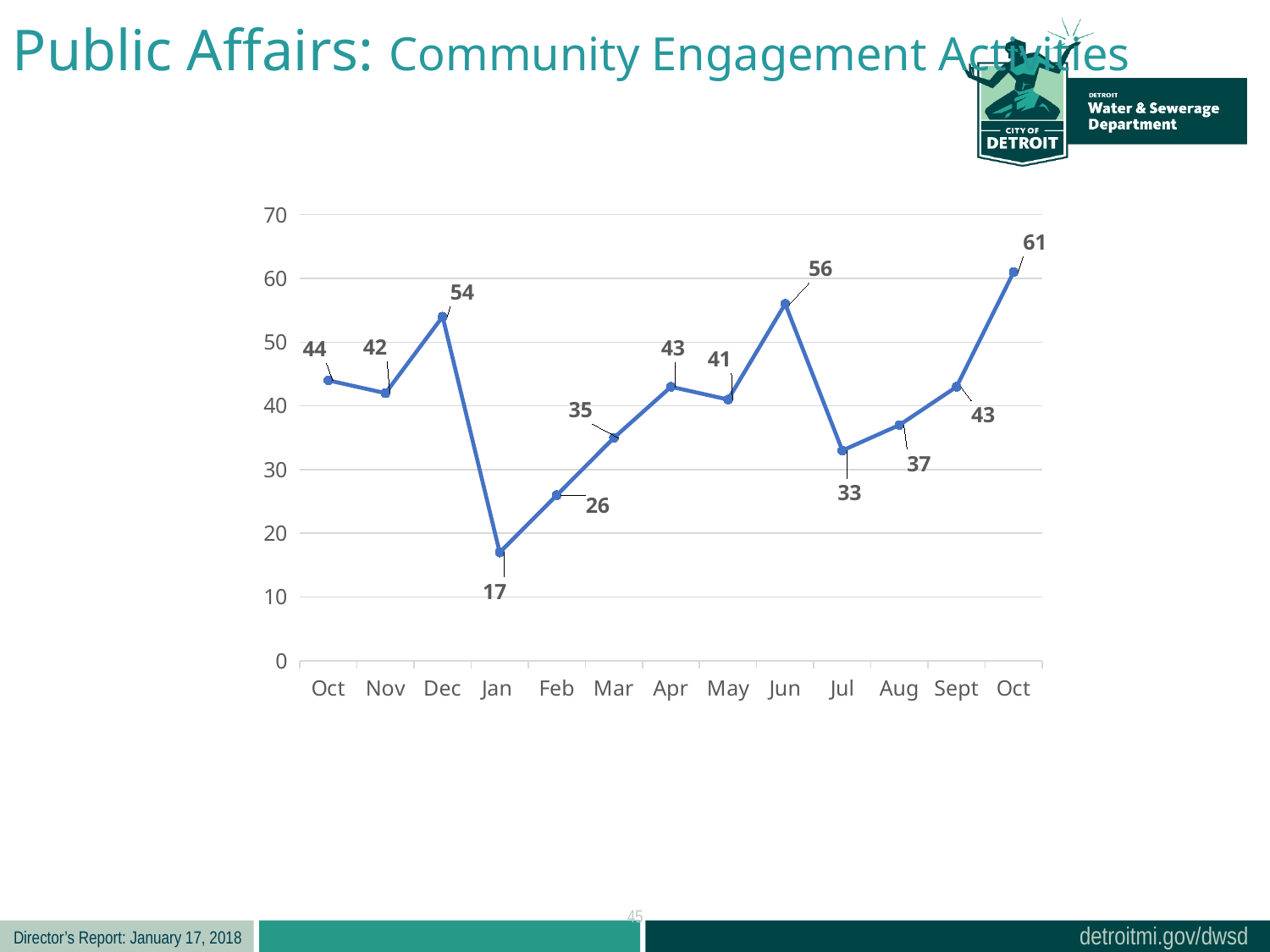
Which month has the lowest value? Jan What is the difference between the values for Dec and Jan? 37 Is the value for Feb greater or less than 30? less What kind of chart is shown on the slide? line chart What is the value for the last Oct on the x axis? 61 What is the value for Jun? 56 What is the value for Jan? 17 Which is larger, the value for Aug or the value for Jul? Aug Which month has the highest value? Oct (the last point) What is the difference between the values for Jun and Jul? 23 Do the values rise or fall from Jan to Apr? rise How many data points are plotted on the line? 13